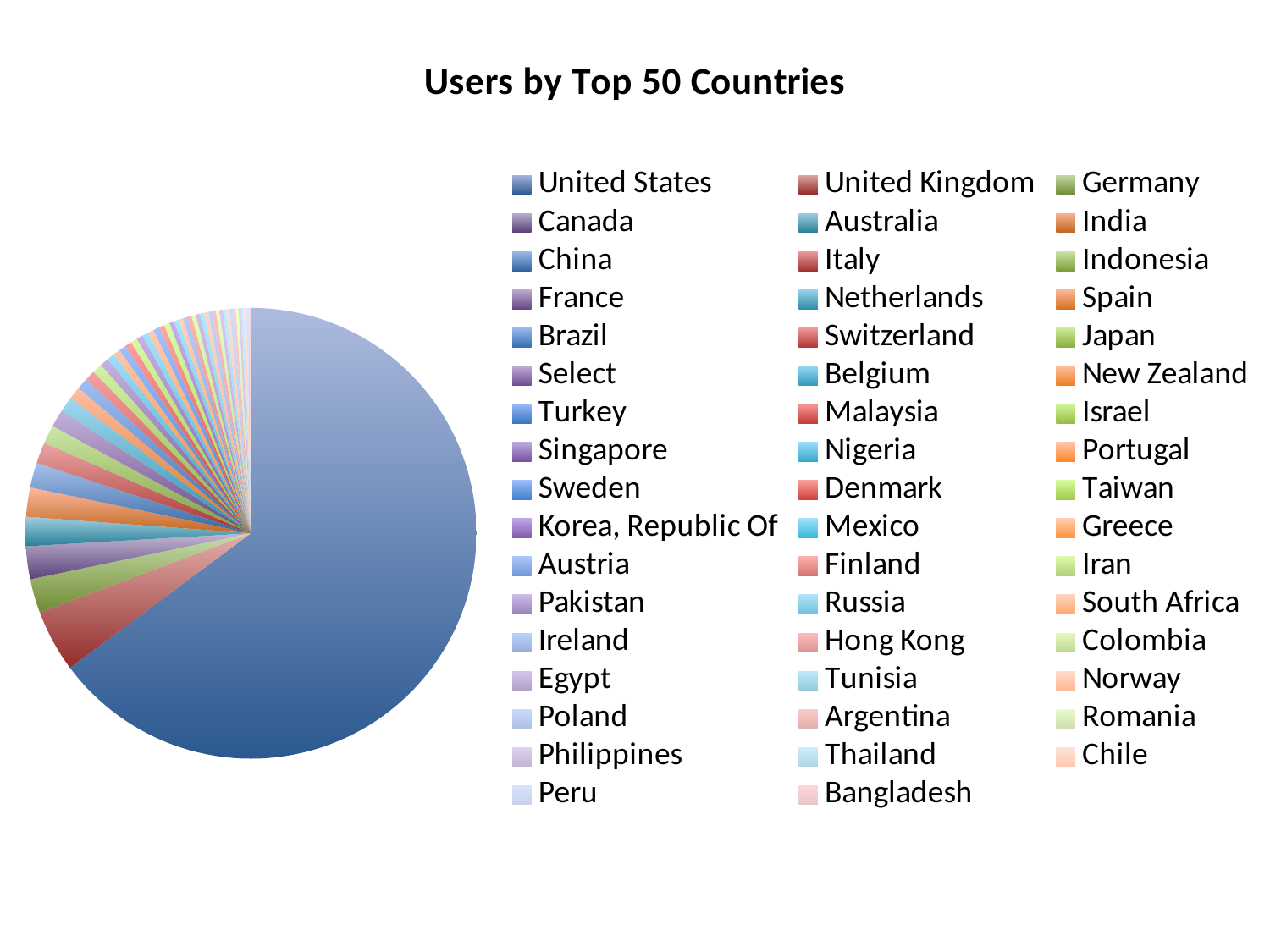
Which slice is larger, United States or Canada? United States Which slice is larger, United States or United Kingdom? United States What kind of chart is shown on the slide? pie chart Which country has the largest slice of the pie? United States What is the title of the chart? Users by Top 50 Countries Which slice is larger, United Kingdom or Canada? United Kingdom How many countries (categories) does the legend list? 50 Is the United States slice greater or less than 50% of the pie? greater Which country is listed first in the legend? United States